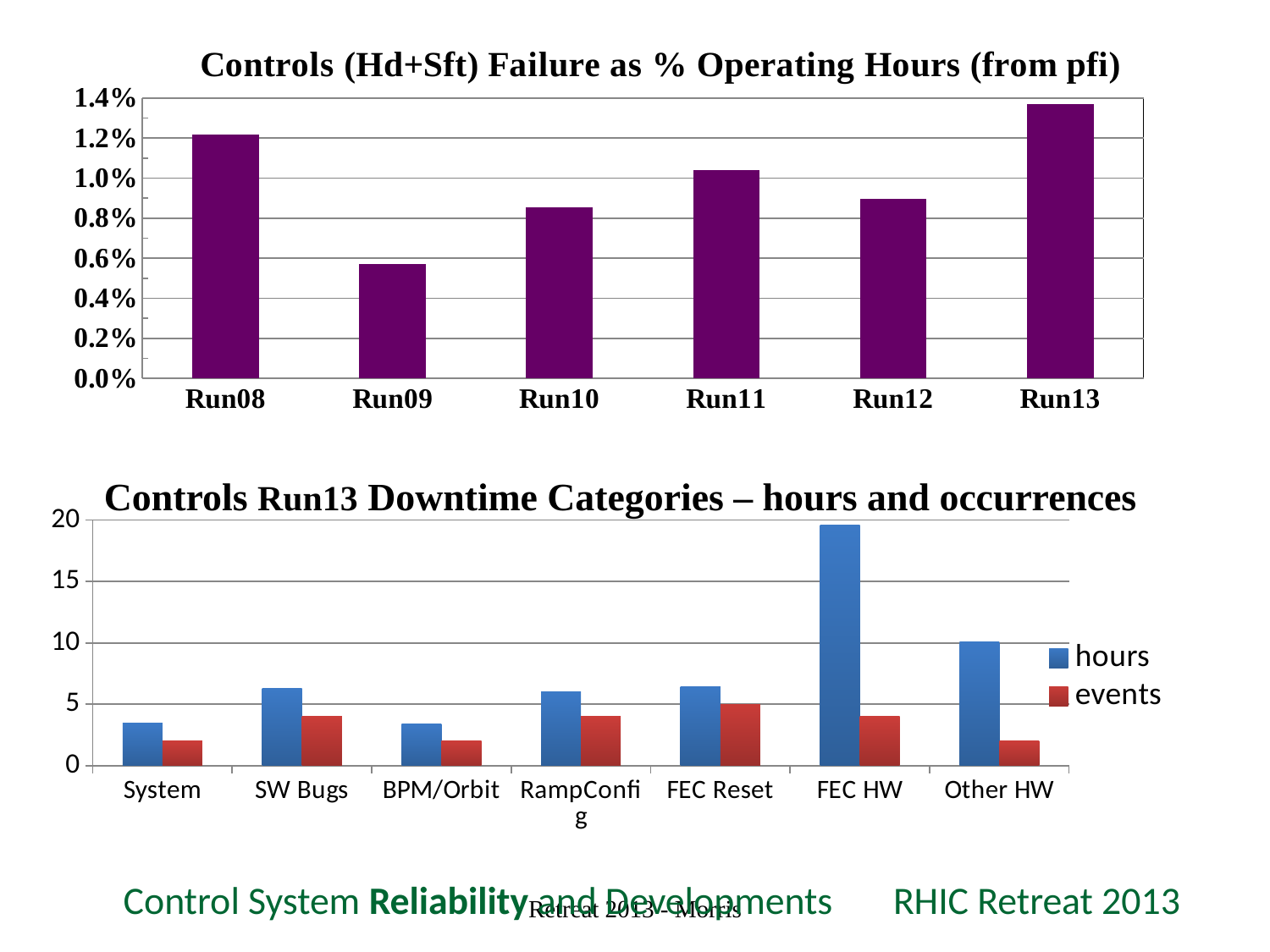
How many series does the legend of the bottom chart list? 2 In the top chart, which is larger, the value for Run11 or the value for Run12? Run11 In the top chart, which run has the lowest controls failure percentage? Run09 In the bottom chart, which category has the highest number of hours? FEC HW In the top chart, is the value for Run08 greater or less than 1.0%? greater How many runs are shown in the top chart? 6 In the bottom chart, is the hours value for System greater or less than 5? less In the top chart, which run has the highest controls failure percentage? Run13 In the bottom chart, is the hours value for FEC HW greater or less than 15? greater How many downtime categories are shown in the bottom chart? 7 What type of chart is the top chart? bar chart